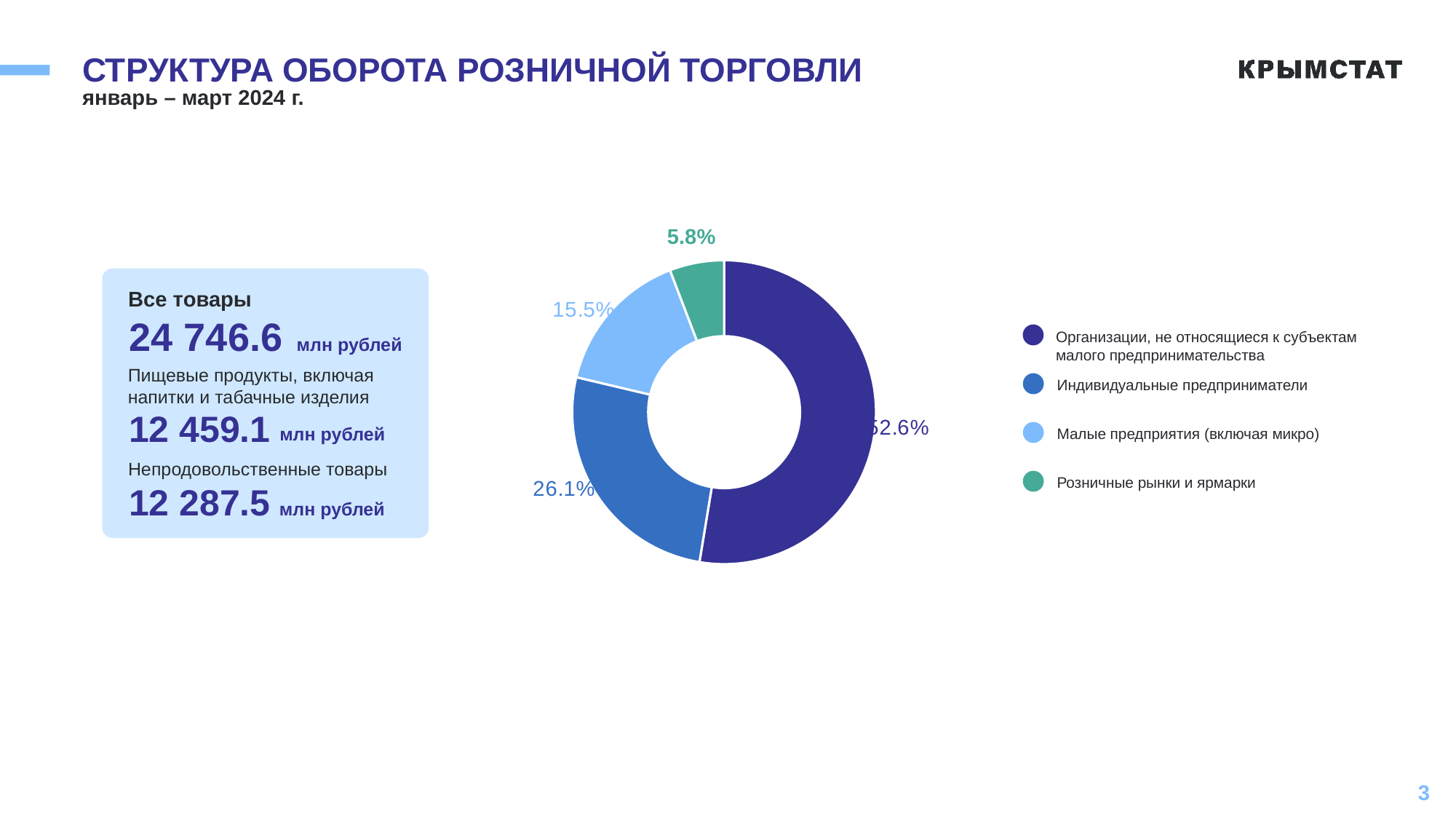
What kind of chart is shown on the slide? Pie chart (donut) Which category is shown in green in the pie chart? Розничные рынки и ярмарки Which category has the smallest share of the pie chart? Розничные рынки и ярмарки What share of retail trade turnover is attributed to Организации, не относящиеся к субъектам малого предпринимательства? 52.6% What is the difference in percentage points between the shares of Малые предприятия (включая микро) and Розничные рынки и ярмарки? 9.7 How many categories are shown in the pie chart? 4 What share of retail trade turnover is attributed to Малые предприятия (включая микро)? 15.5% What share of retail trade turnover is attributed to Розничные рынки и ярмарки? 5.8% What share of retail trade turnover is attributed to Индивидуальные предприниматели? 26.1% What is the difference in percentage points between the shares of Индивидуальные предприниматели and Малые предприятия (включая микро)? 10.6 Which has a larger share: Индивидуальные предприниматели or Малые предприятия (включая микро)? Индивидуальные предприниматели Which category has the largest share of the pie chart? Организации, не относящиеся к субъектам малого предпринимательства